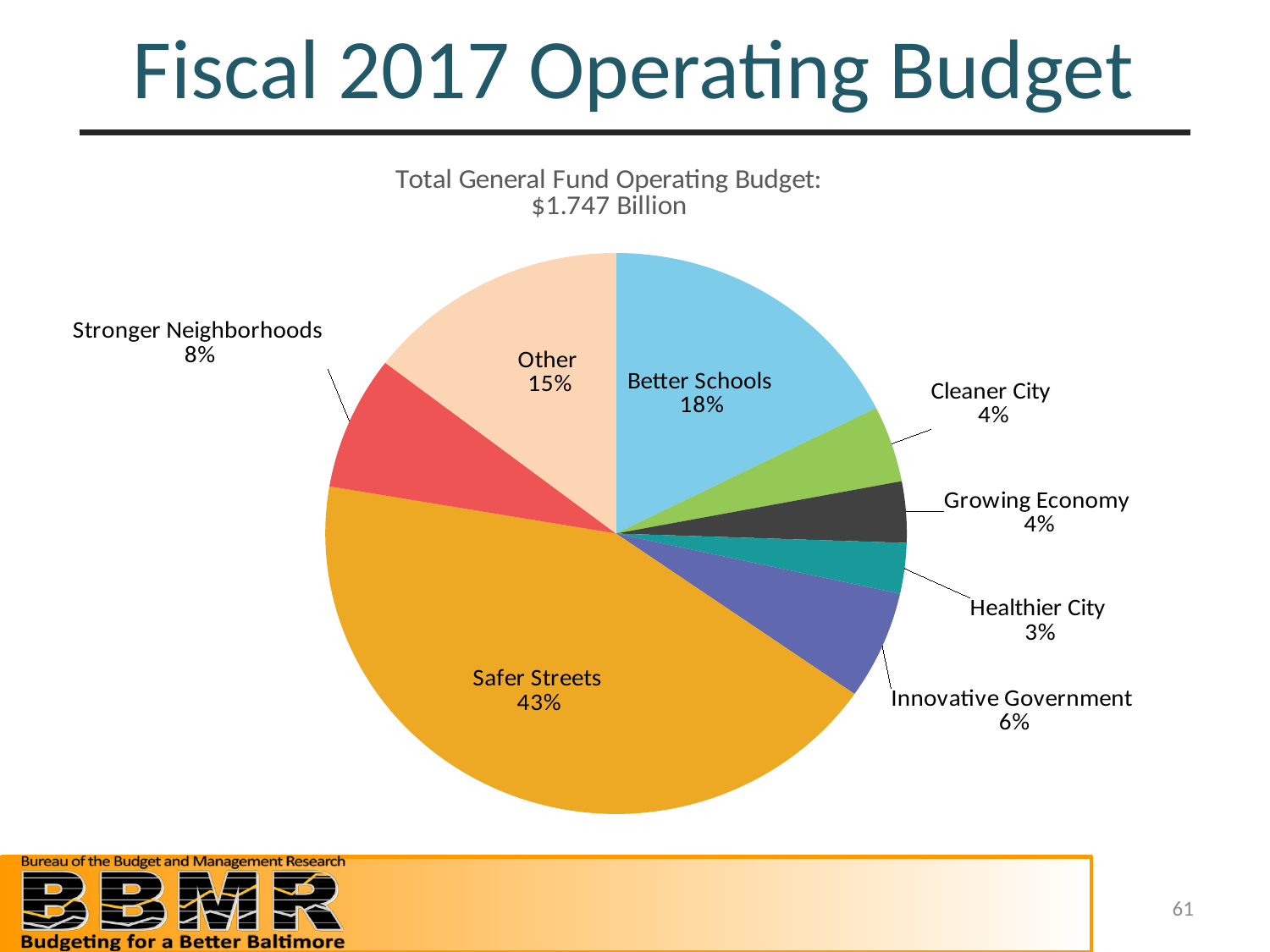
What total general fund operating budget is stated in the chart title? $1.747 Billion Which category has the largest slice of the pie? Safer Streets Which is larger, the share for Other or the share for Stronger Neighborhoods? Other What kind of chart is shown on the slide? pie chart What share of the budget goes to Better Schools? 18% How many slices does the pie chart have? 8 What share of the budget goes to Safer Streets? 43% What percentage is shown for Innovative Government? 6% Which category has the smallest slice of the pie? Healthier City What is the combined percentage of Cleaner City and Growing Economy? 8% What is the difference in percentage points between Safer Streets and Better Schools? 25 What percentage is shown for Healthier City? 3%